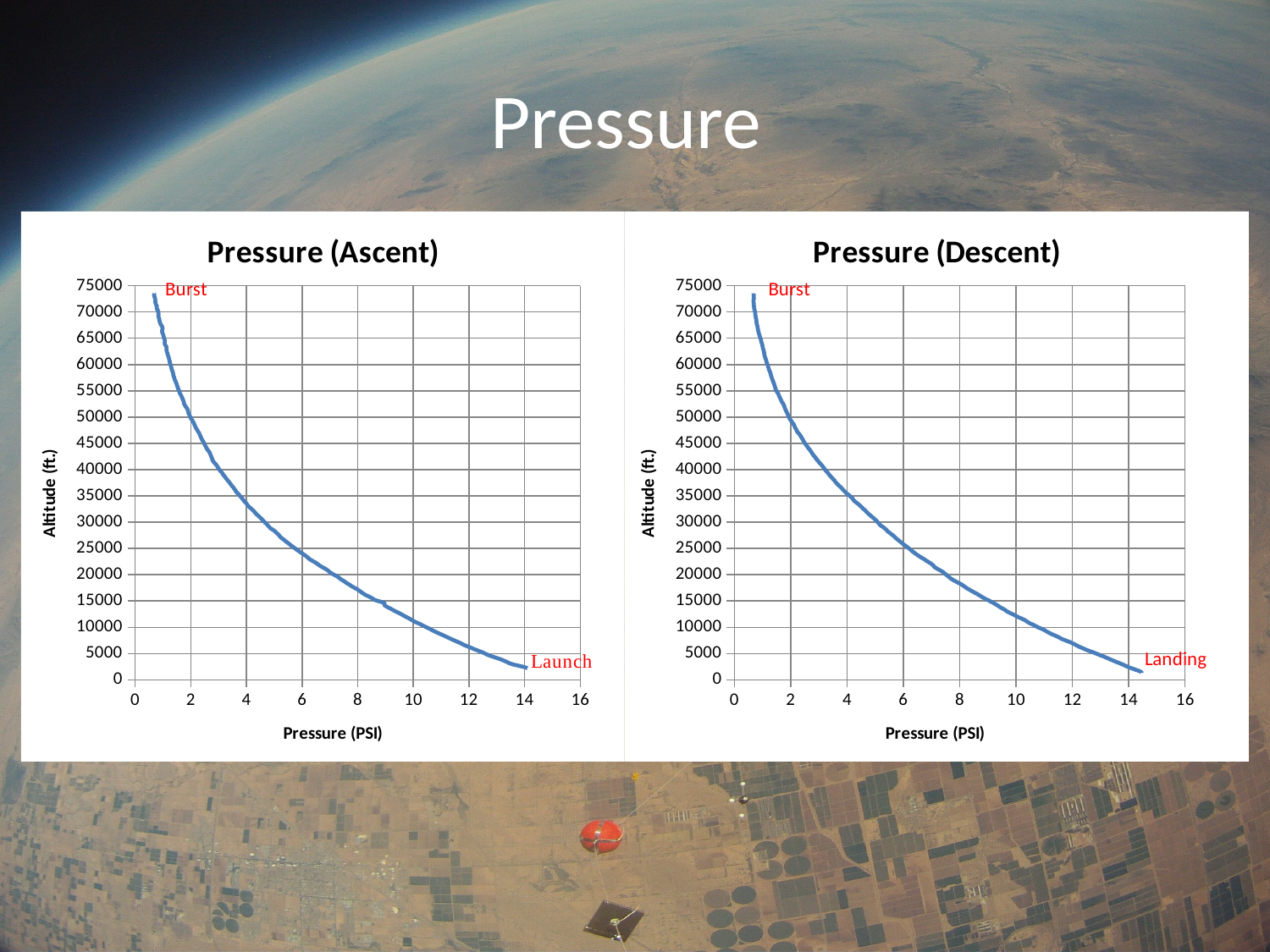
What is the label of the y axis on the Pressure (Descent) chart? Altitude (ft.) In the Pressure (Descent) chart, is the altitude at the point labelled Landing greater or less than 5000 ft? less In the Pressure (Descent) chart, does altitude rise or fall as pressure increases along the x axis? fall In the Pressure (Ascent) chart, is the pressure at the point labelled Burst greater or less than 2 PSI? less What kind of chart is the Pressure (Descent) chart? line chart In the Pressure (Descent) chart, is the altitude at the point labelled Burst greater or less than 70000 ft? greater What is the label of the x axis on the Pressure (Ascent) chart? Pressure (PSI) In the Pressure (Ascent) chart, does altitude rise or fall as pressure increases along the x axis? fall What kind of chart is the Pressure (Ascent) chart? line chart